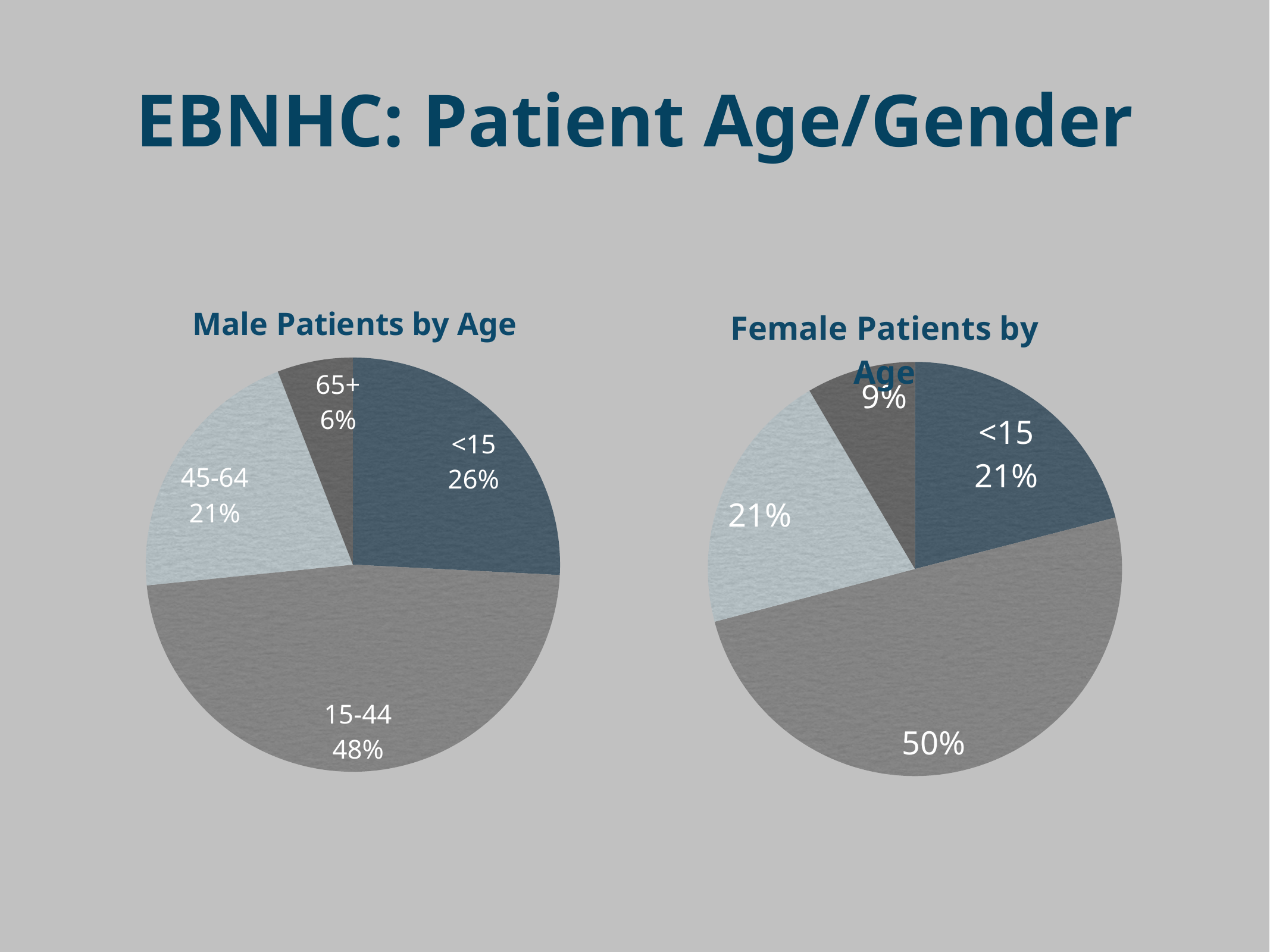
In the Male Patients by Age chart, which age group has the smallest share? 65+ What type of chart is used for the Male Patients by Age chart? Pie chart In the Female Patients by Age chart, what is the percentage shown on the smallest slice? 9% In the Male Patients by Age chart, which is larger: the <15 share or the 45-64 share? <15 In the Male Patients by Age chart, how many percentage points larger is the 15-44 share than the 45-64 share? 27 How many slices does the Male Patients by Age pie chart have? 4 In the Female Patients by Age chart, what is the percentage shown on the largest slice? 50% In the Male Patients by Age chart, what share of male patients are 65+? 6% In the Male Patients by Age chart, what percentage of male patients are under 15? 26% In the Male Patients by Age chart, what share of male patients are aged 15-44? 48% In the Female Patients by Age chart, what percentage of female patients are under 15? 21% In the Male Patients by Age chart, which age group has the largest share? 15-44